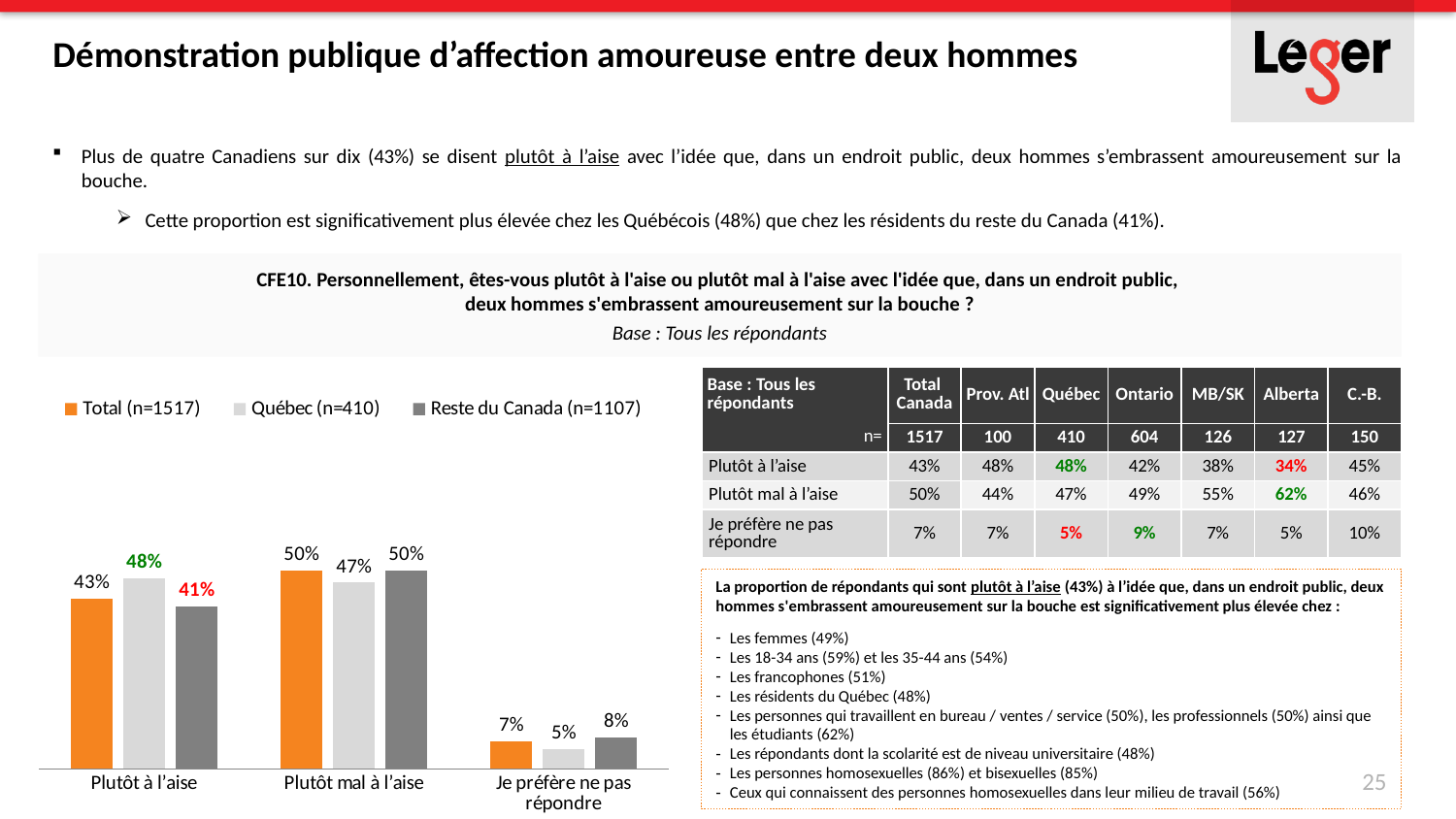
What is the value for Reste du Canada (n=1107) in the 'Plutôt mal à l'aise' category? 50% Which series is shown in orange in the chart? Total (n=1517) How many categories are shown on the x axis of the chart? 3 What is the difference between the Reste du Canada (n=1107) and Total (n=1517) values in the 'Je préfère ne pas répondre' category? 1% Which series has the lowest value in the 'Je préfère ne pas répondre' category? Québec (n=410) What type of chart is shown on the slide? bar chart How many series does the chart legend list? 3 Which is larger in the 'Plutôt mal à l'aise' category: the Total (n=1517) value or the Québec (n=410) value? Total (n=1517) What is the difference between the Québec (n=410) and Reste du Canada (n=1107) values in the 'Plutôt à l'aise' category? 7% Which series has the highest value in the 'Plutôt à l'aise' category? Québec (n=410) What is the value for Québec (n=410) in the 'Plutôt à l'aise' category? 48% What is the value for Total (n=1517) in the 'Je préfère ne pas répondre' category? 7%